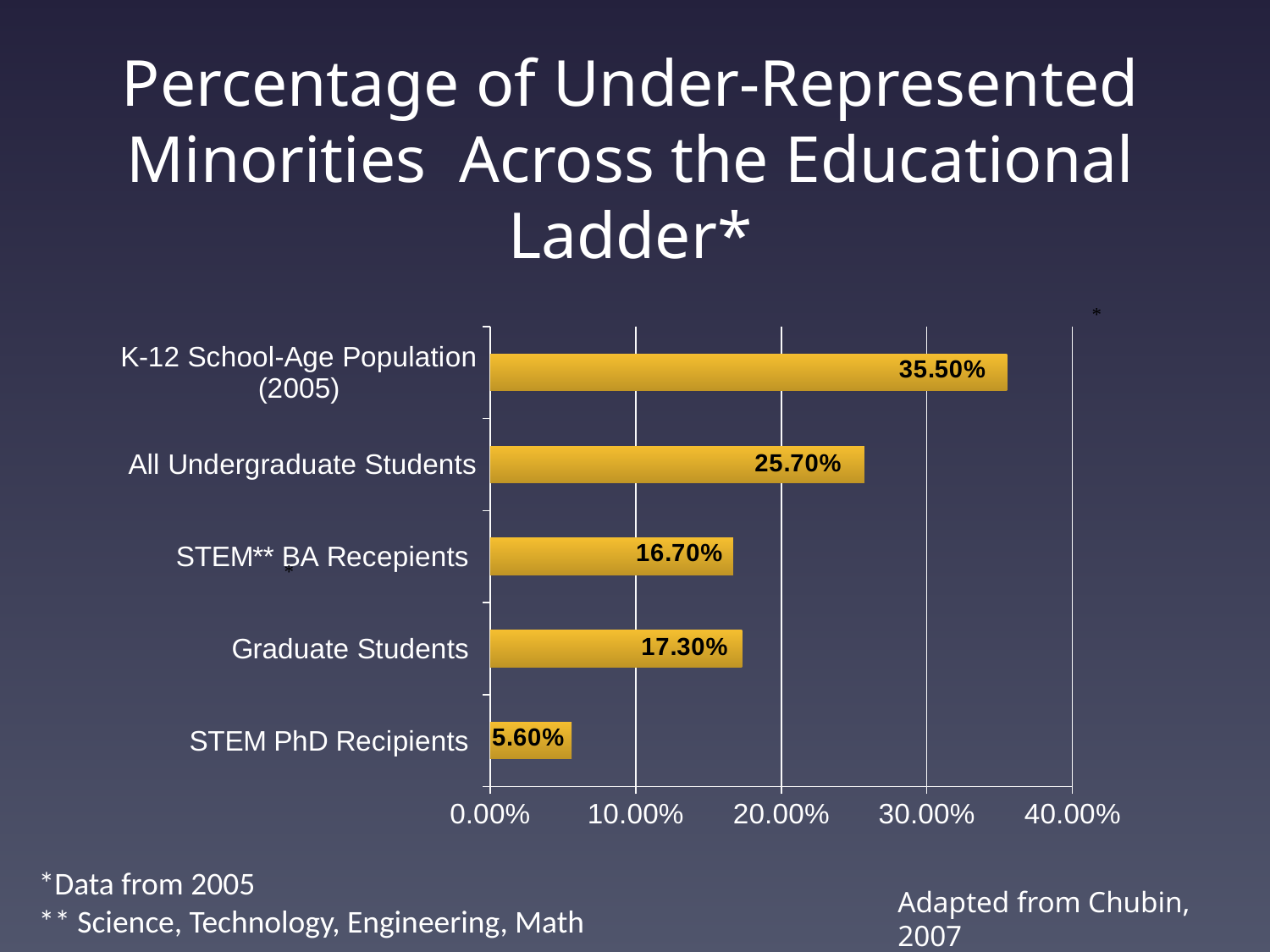
Which is larger, the value for All Undergraduate Students or the value for STEM BA Recepients? All Undergraduate Students Which category has the highest value? K-12 School-Age Population (2005) What is the highest value shown on the horizontal axis? 40.00% Which category has the lowest value? STEM PhD Recipients What is the value for Graduate Students? 17.30% What is the difference between the values for K-12 School-Age Population (2005) and All Undergraduate Students? 9.80% What is the value for All Undergraduate Students? 25.70% What kind of chart is shown on the slide? Bar chart What is the value for STEM PhD Recipients? 5.60% What is the difference between the values for Graduate Students and STEM PhD Recipients? 11.70% How many categories are shown in the chart? 5 What is the value for K-12 School-Age Population (2005)? 35.50%